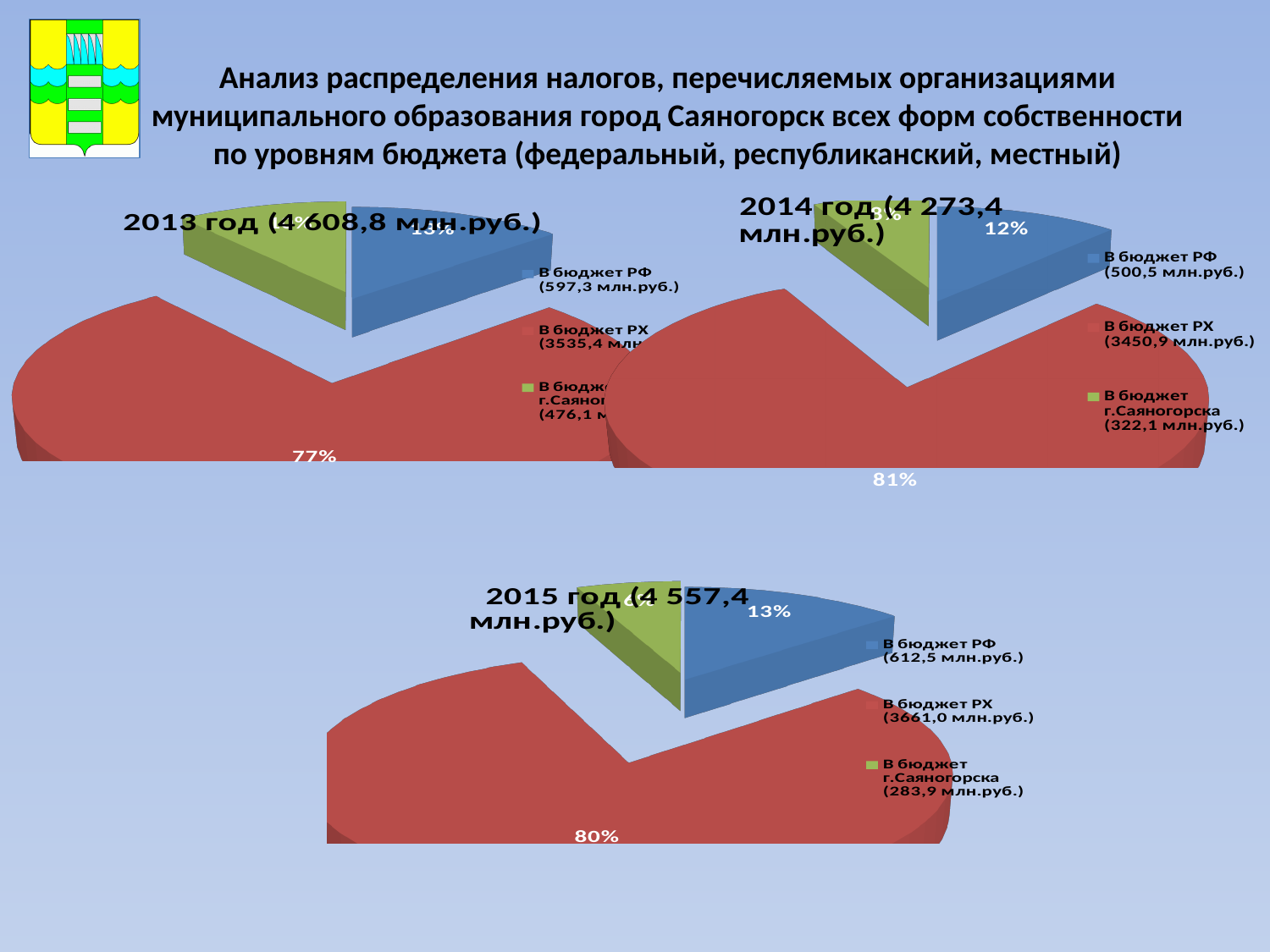
On the 2014 chart, which is larger: the amount to the federal budget (В бюджет РФ) or the amount to the budget of Sayanogorsk (В бюджет г.Саяногорска)? В бюджет РФ On the 2013 chart, what percentage is labelled on the largest (red) slice? 77% On the 2014 chart, which budget level receives the largest share? В бюджет РХ On the 2014 chart, what share of the pie goes to the budget of the Republic of Khakassia (В бюджет РХ)? 81% On the 2014 chart, what share of the pie goes to the federal budget (В бюджет РФ)? 12% How many entries does the legend of the 2014 chart list? 3 On the 2015 chart, what amount is shown in the legend for the federal budget (В бюджет РФ)? 612,5 млн.руб. On the 2014 chart, what amount is shown in the legend for the budget of Sayanogorsk (В бюджет г.Саяногорска)? 322,1 млн.руб. What type of chart is used for the 2015 data? Pie chart On the 2015 chart, which budget level receives the smallest share? В бюджет г.Саяногорска On the 2015 chart, what amount is shown in the legend for the budget of the Republic of Khakassia (В бюджет РХ)? 3661,0 млн.руб.